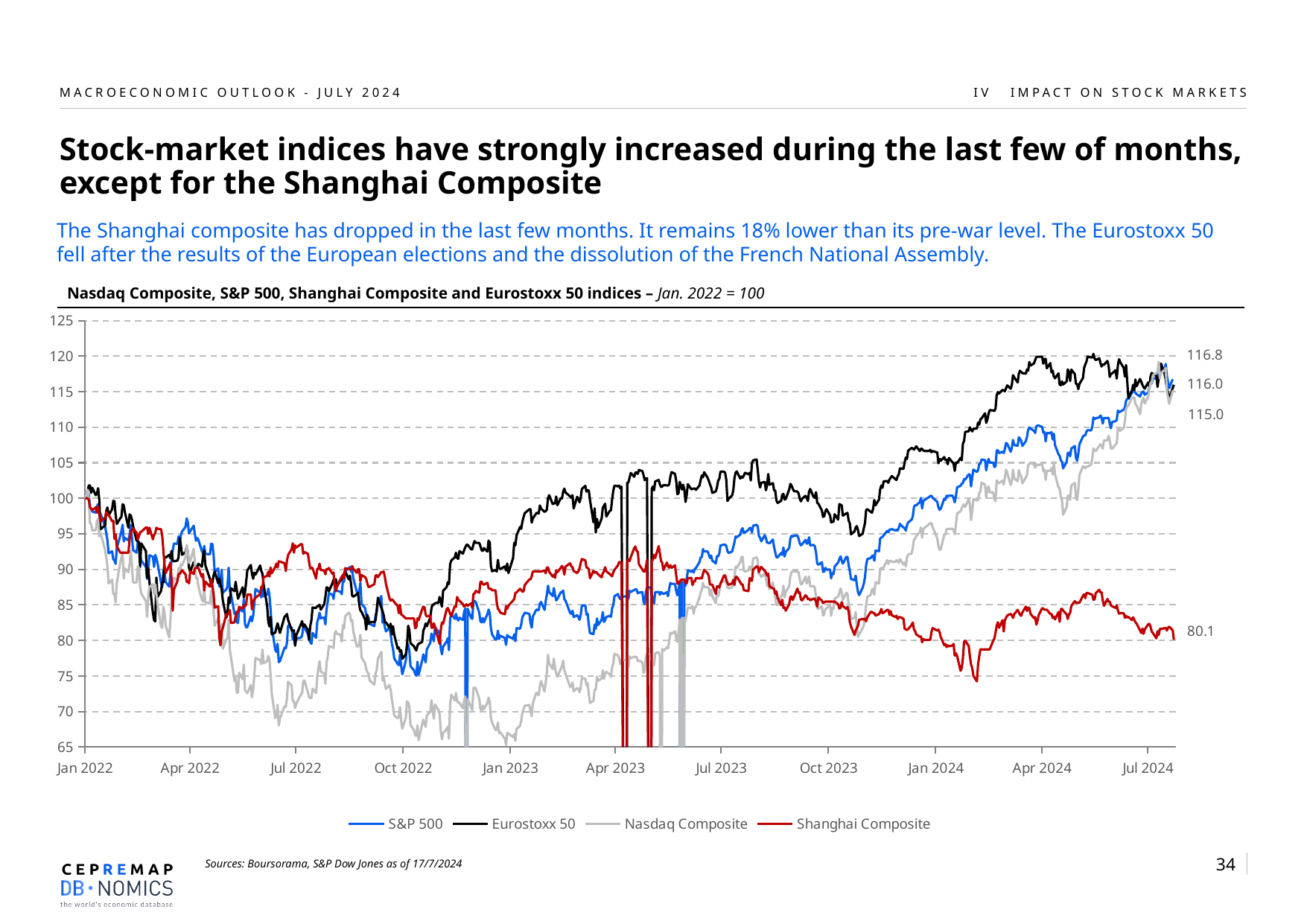
Which index has the highest value around Apr 2024? Eurostoxx 50 What is the value of the Shanghai Composite at the end of the series (Jul 2024)? 80.1 Is the value of the Shanghai Composite at Jul 2024 greater or less than 85? less What colour is the Shanghai Composite line? red What kind of chart is shown on the slide? line chart Is the value of the Eurostoxx 50 at Jul 2024 greater or less than 110? greater How many series does the legend list? 4 Which index has the lowest value at the end of the period shown? Shanghai Composite At the end of the period, which is larger: the S&P 500 or the Shanghai Composite? S&P 500 What base period is used for the indices, according to the chart title? Jan. 2022 = 100 Is the value of the Nasdaq Composite around Oct 2022 greater or less than 80? less Does the Shanghai Composite rise or fall between Apr 2024 and Jul 2024? fall